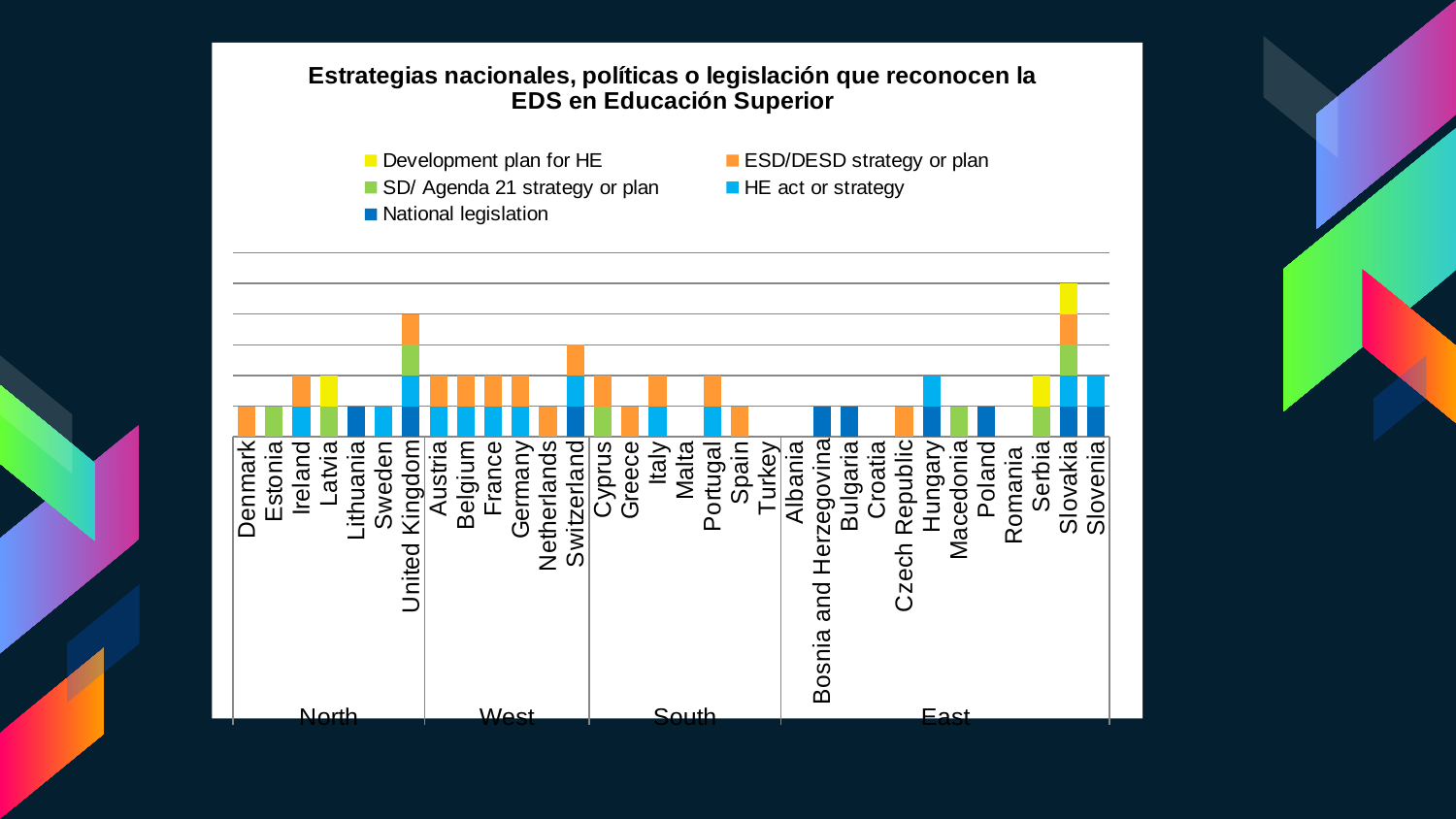
Which country has the tallest stacked bar? Slovakia Which countries show no bar at all? Malta, Turkey, Albania, Croatia, Romania Which has the taller stacked bar, United Kingdom or Switzerland? United Kingdom What kind of chart is shown on the slide? Stacked bar chart How many series does the legend list? 5 Which regional group contains the most countries? East What is the title of the chart? Estrategias nacionales, políticas o legislación que reconocen la EDS en Educación Superior How many regional groups are the countries divided into along the x axis? 4 Which has the taller stacked bar, Switzerland or Netherlands? Switzerland Which legend entry is shown in yellow? Development plan for HE How many countries are shown along the x axis? 32 Which has the taller stacked bar, Slovakia or United Kingdom? Slovakia